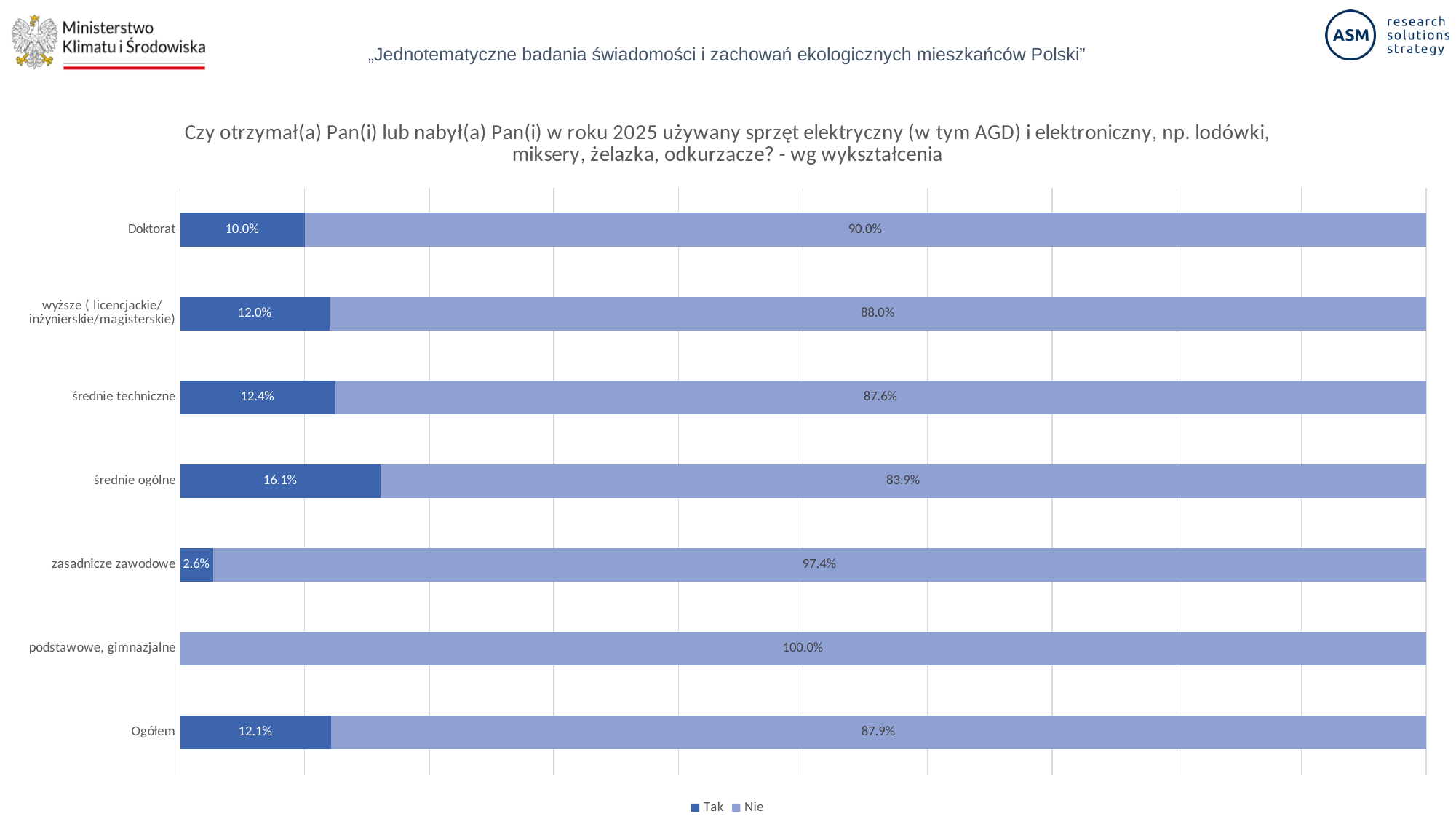
Which is larger: the 'Tak' value for średnie techniczne or for Doktorat? średnie techniczne Which education category has the lowest 'Nie' value? średnie ogólne What is the difference between the 'Tak' values for średnie ogólne and zasadnicze zawodowe? 13.5% Which education category has the highest 'Tak' value? średnie ogólne What kind of chart is shown on the slide? Stacked bar chart What is the 'Tak' value for Ogółem? 12.1% What is the 'Tak' value for Doktorat? 10.0% What is the 'Nie' value for podstawowe, gimnazjalne? 100.0% What is the 'Nie' value for średnie ogólne? 83.9% How many series does the legend list? 2 How many education categories are shown on the chart? 7 What is the total of the stacked bar for wyższe (licencjackie/inżynierskie/magisterskie)? 100.0%